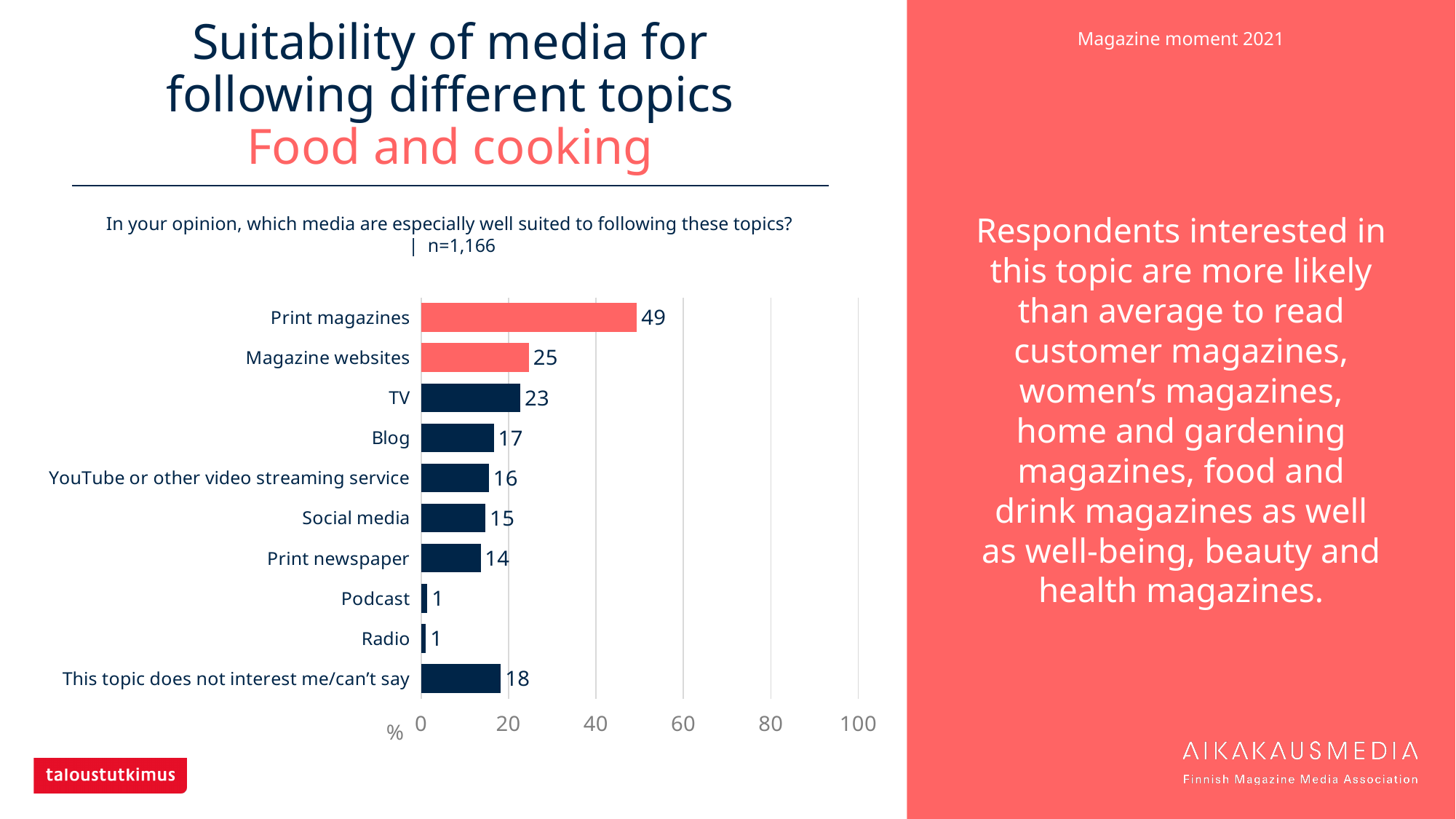
What is the value for YouTube or other video streaming service? 16 Is the value for Print magazines greater or less than 40? greater What is the difference between the values for TV and Print newspaper? 9 What kind of chart is shown on the slide? bar chart Which category has the highest value? Print magazines What is the sample size (n) stated above the chart? n=1,166 Which is larger, the value for Blog or the value for Social media? Blog How many categories are shown in the chart? 10 What is the value for Print magazines? 49 What is the value for 'This topic does not interest me/can't say'? 18 What is the value for Magazine websites? 25 What is the difference between the values for Print magazines and Magazine websites? 24